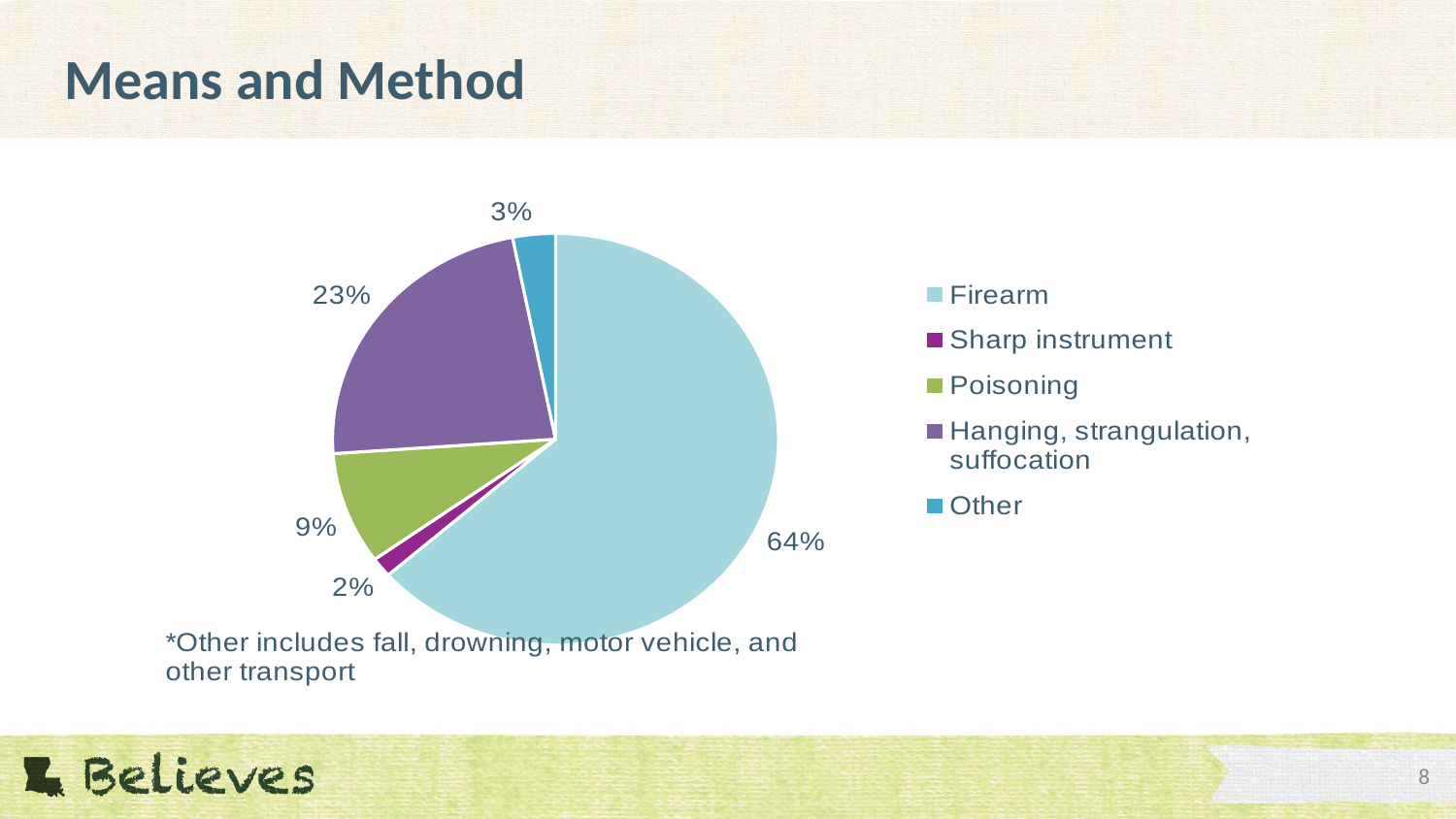
What percentage is shown for Poisoning? 9% What percentage is shown for Hanging, strangulation, suffocation? 23% What is the difference in percentage points between Firearm and Hanging, strangulation, suffocation? 41 Which category has the smallest slice of the pie? Sharp instrument How many categories does the legend list? 5 What is the title of the slide containing the chart? Means and Method Which is larger, the share for Poisoning or the share for Other? Poisoning Which category has the largest slice of the pie? Firearm What percentage is shown for Other? 3% What share of the pie does Firearm account for? 64% What percentage is shown for Sharp instrument? 2% What type of chart is shown on the slide? pie chart